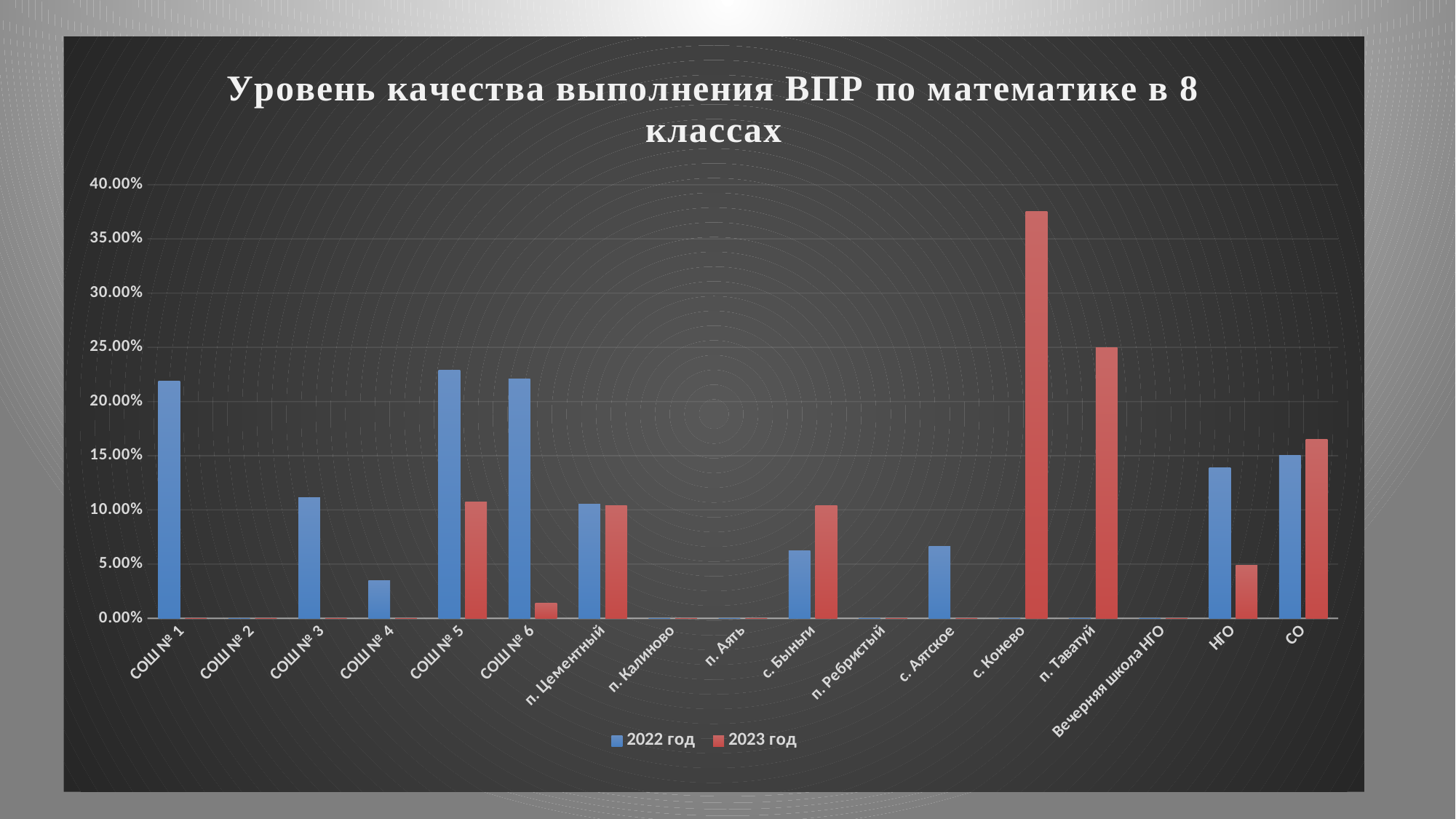
Is the value for СОШ № 4 in 2022 год greater or less than 5.00%? less For НГО, which series has the larger value, 2022 год or 2023 год? 2022 год What kind of chart is shown on the slide? bar chart Is the value for СОШ № 6 in 2023 год greater or less than 5.00%? less How many series does the legend list? 2 How many categories are shown on the x axis? 17 Is the value for СОШ № 1 in 2022 год greater or less than 20.00%? greater For с. Быньги, which series has the larger value, 2022 год or 2023 год? 2023 год What is the title of the chart? Уровень качества выполнения ВПР по математике в 8 классах Which category has the highest value for 2023 год? с. Конево